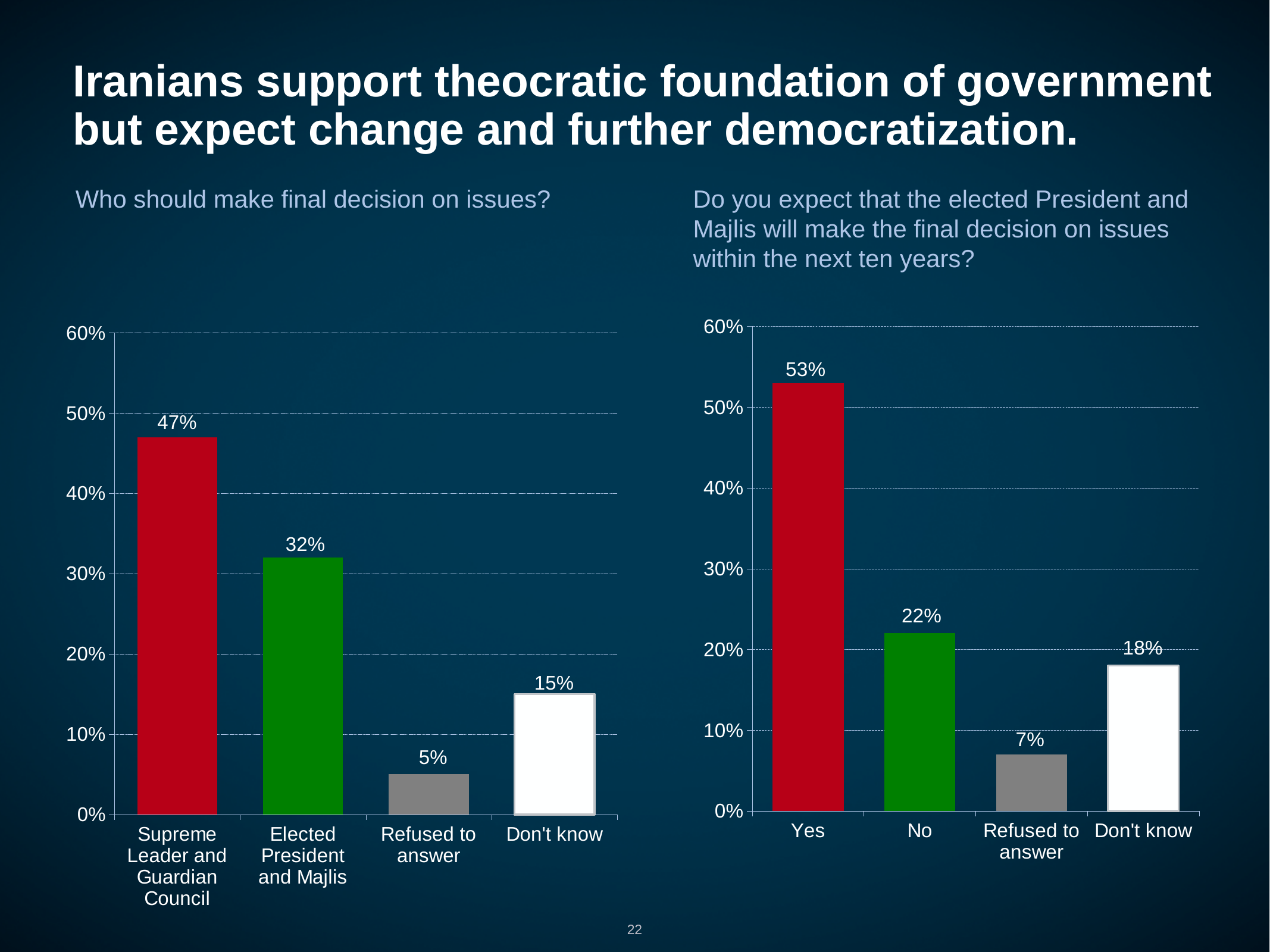
What type of chart is the right chart (expectation for the next ten years)? Bar chart In the right chart (expectation for the next ten years), which category has the highest value? Yes How many categories are shown in the left chart ('Who should make final decision on issues?')? 4 In the right chart (expectation for the next ten years), what colour is the Yes bar? Red In the left chart ('Who should make final decision on issues?'), what percentage chose Elected President and Majlis? 32% In the right chart (expectation for the next ten years), what percentage answered Yes? 53% In the left chart ('Who should make final decision on issues?'), what percentage chose Supreme Leader and Guardian Council? 47% In the right chart (expectation for the next ten years), what percentage answered No? 22% In the right chart (expectation for the next ten years), what is the difference between Yes and No? 31 percentage points In the right chart (expectation for the next ten years), which is larger: No or Don't know? No In the left chart ('Who should make final decision on issues?'), which category has the lowest value? Refused to answer In the left chart ('Who should make final decision on issues?'), what is the difference between Supreme Leader and Guardian Council and Elected President and Majlis? 15 percentage points